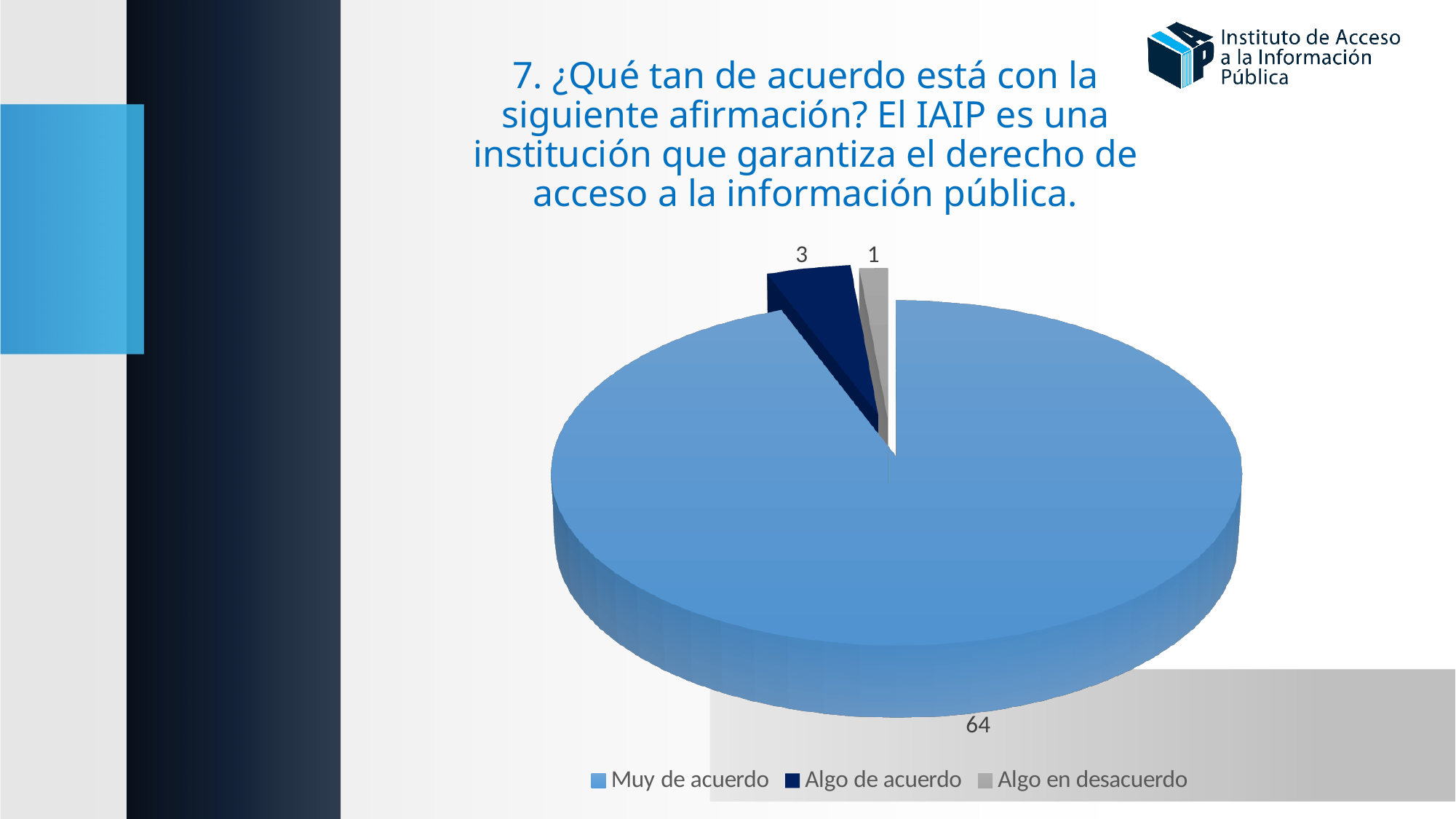
Which category has the smallest slice of the pie? Algo en desacuerdo What is the value for "Algo en desacuerdo"? 1 What is the total of all the values shown in the pie chart? 68 What is the value for "Muy de acuerdo"? 64 What type of chart is shown on the slide? Pie chart What is the difference between the values for "Algo de acuerdo" and "Algo en desacuerdo"? 2 What is the difference between the values for "Muy de acuerdo" and "Algo de acuerdo"? 61 Which category has the largest slice of the pie? Muy de acuerdo What is the value for "Algo de acuerdo"? 3 Which is larger, the value for "Algo de acuerdo" or the value for "Algo en desacuerdo"? Algo de acuerdo Which legend entry is shown in dark navy blue? Algo de acuerdo How many categories does the pie chart show? 3